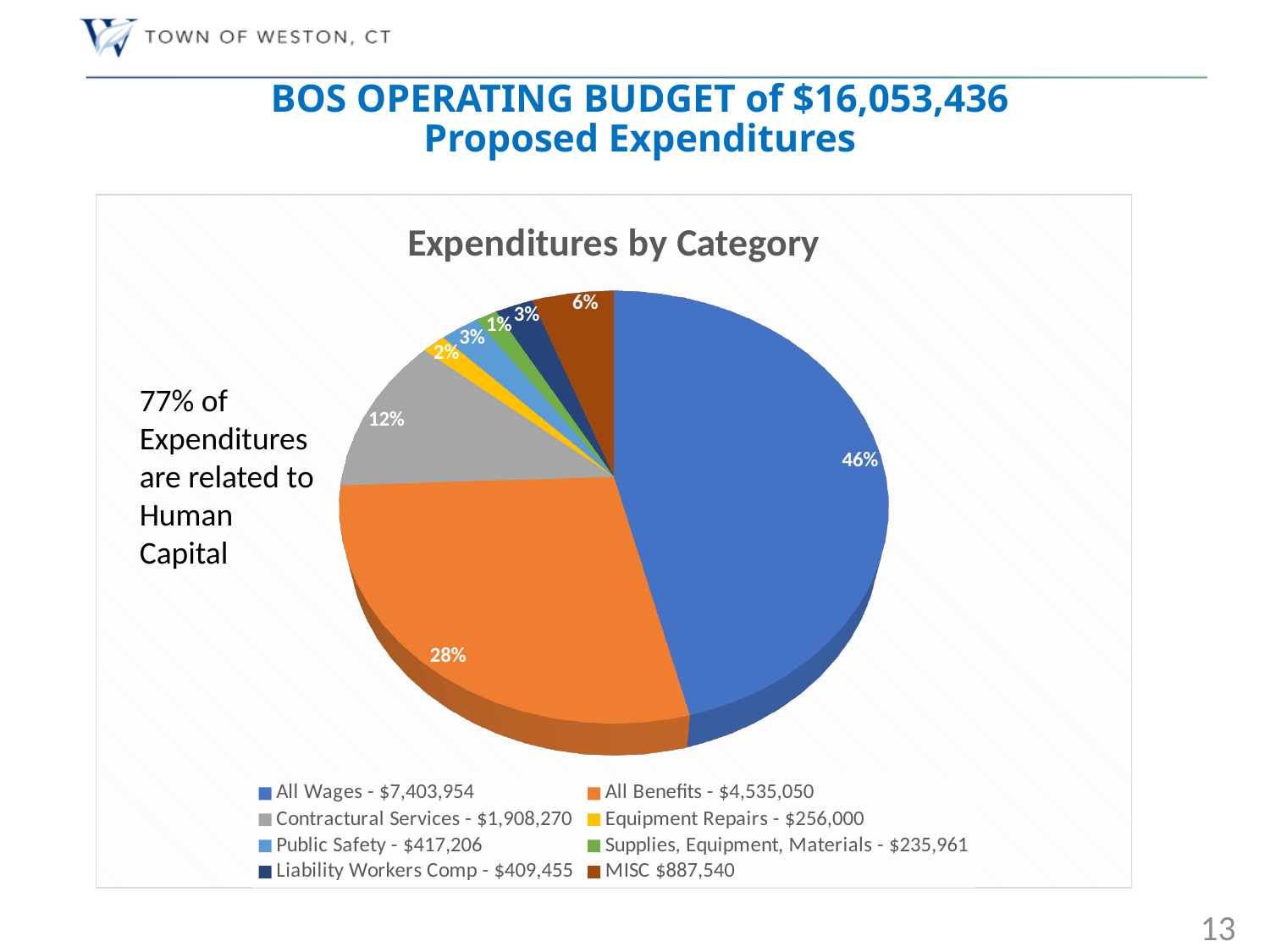
What is the dollar amount shown in the legend for Public Safety? $417,206 What share of expenditures is Contractural Services? 12% What kind of chart is shown on the slide? pie chart What is the title of the chart? Expenditures by Category What share of expenditures is All Wages? 46% What is the difference in percentage points between the All Wages share and the All Benefits share? 18% Which category has the largest share of the pie? All Wages How many categories does the legend list? 8 What share of expenditures is All Benefits? 28% What is the dollar amount shown in the legend for All Benefits? $4,535,050 Which category has the smallest share of the pie? Supplies, Equipment, Materials